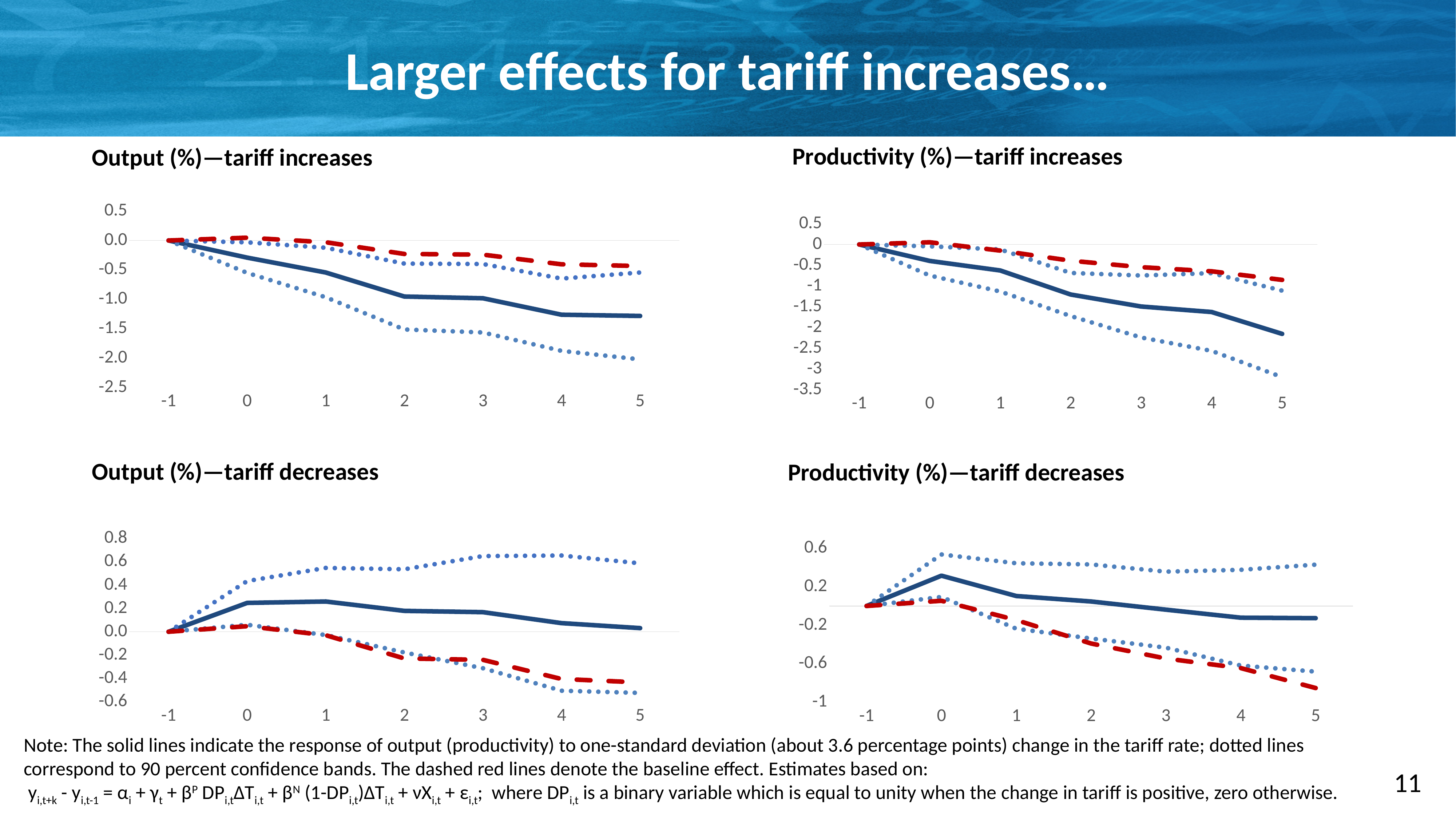
According to the note, what do the dashed red lines denote? the baseline effect In the "Output (%)—tariff increases" chart, does the solid line rise or fall from -1 to 5 on the x axis? fall In the "Productivity (%)—tariff increases" chart, is the value of the solid line at x = 5 greater or less than -2? less In the "Output (%)—tariff increases" chart, is the value of the solid line at x = 5 greater or less than -1.0? less In the "Productivity (%)—tariff decreases" chart, is the value of the dashed red line at x = 5 greater or less than -0.6? less In the "Output (%)—tariff increases" chart, at x = 5, which is larger: the solid line or the dashed red line? the dashed red line What kind of chart is the "Output (%)—tariff increases" chart? line chart In the "Productivity (%)—tariff increases" chart, does the solid line rise or fall from -1 to 5 on the x axis? fall How many points are on the x axis of the "Productivity (%)—tariff decreases" chart? 7 What is the title of the chart in the bottom-left of the slide? Output (%)—tariff decreases